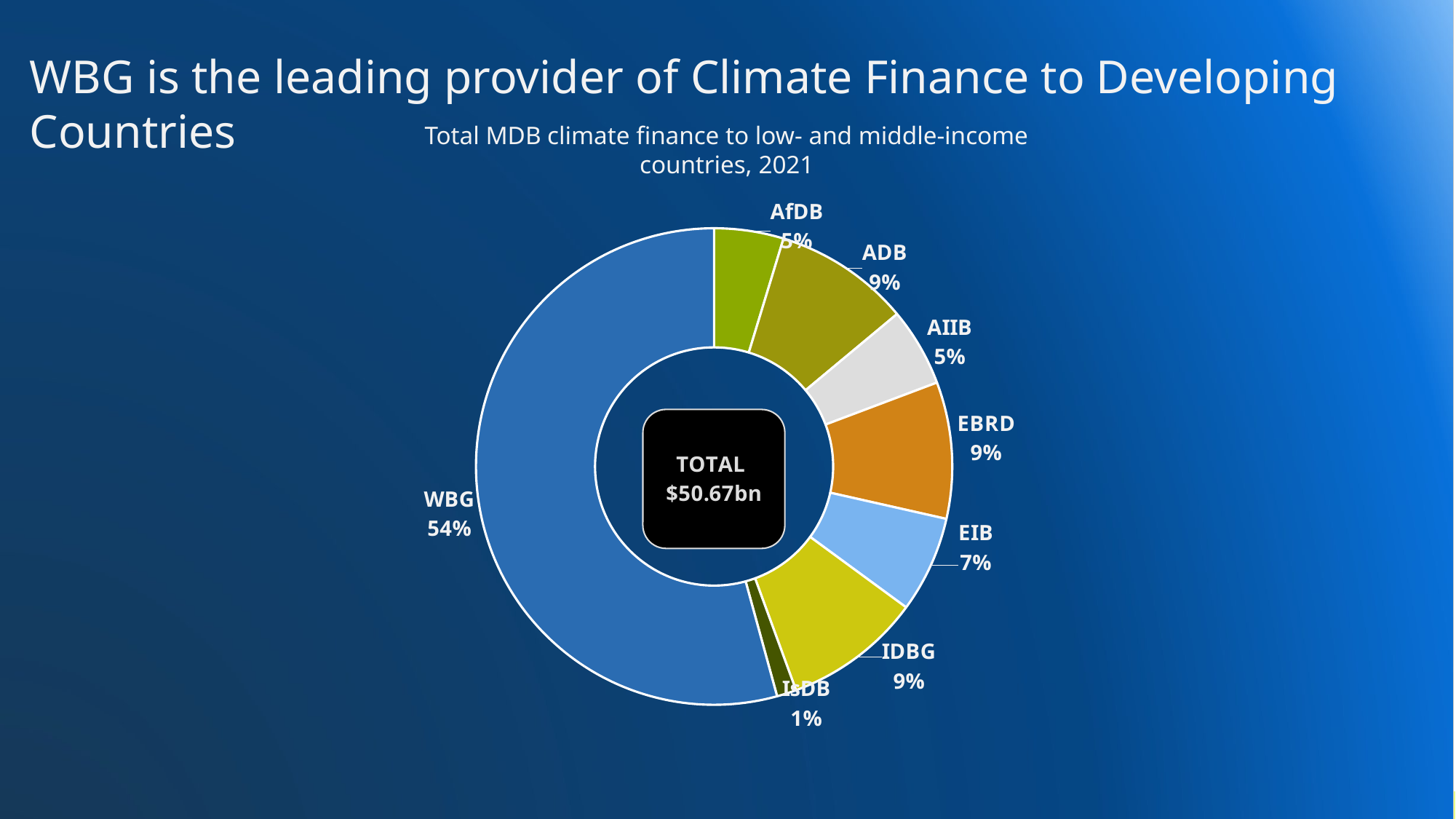
Which institution has the largest share of the pie? WBG What total value is displayed in the centre of the chart? $50.67bn What share does IsDB hold in the chart? 1% What is EIB's share of the total MDB climate finance shown? 7% What percentage of the pie is attributed to EBRD? 9% Which has a larger share, EIB or AIIB? EIB How many institutions (slices) are shown in the chart? 8 What is the title of the chart? Total MDB climate finance to low- and middle-income countries, 2021 What is the difference in percentage points between WBG's share and ADB's share? 45 percentage points What share of total MDB climate finance to low- and middle-income countries in 2021 does WBG account for? 54% What type of chart is shown on the slide? Pie chart (donut) Which institution has the smallest share of the pie? IsDB